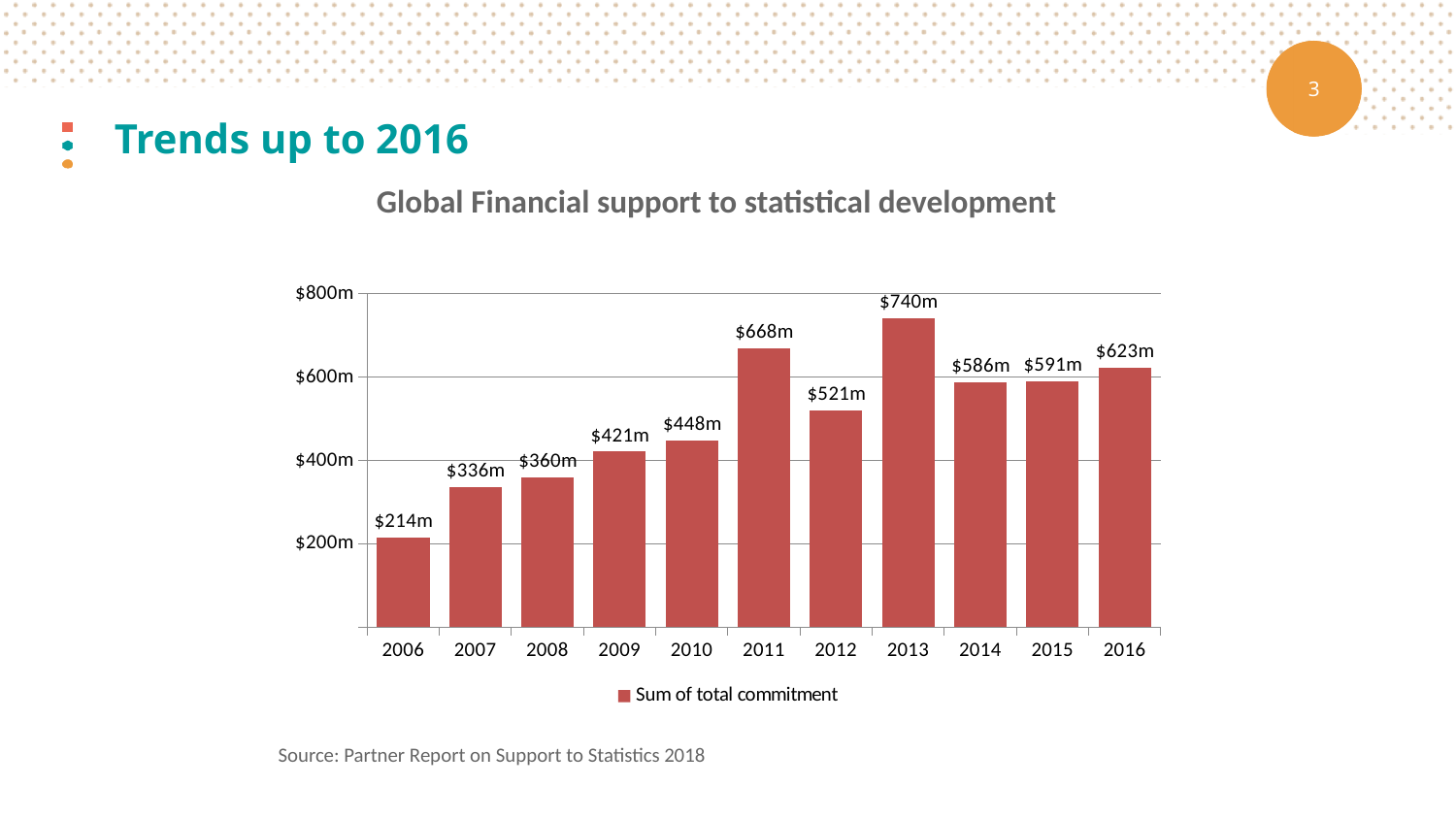
What kind of chart is shown? bar chart Which year has the lowest value? 2006 What is the value for 2016? $623m What is the title of the chart? Global Financial support to statistical development How many series does the legend list? 1 Which is larger, the value for 2011 or the value for 2016? 2011 Which year has the highest value? 2013 What is the difference between the values for 2013 and 2012? $219m What is the value for 2013? $740m What is the value for 2006? $214m Is the value for 2010 greater or less than $400m? greater How many years are shown on the x axis? 11